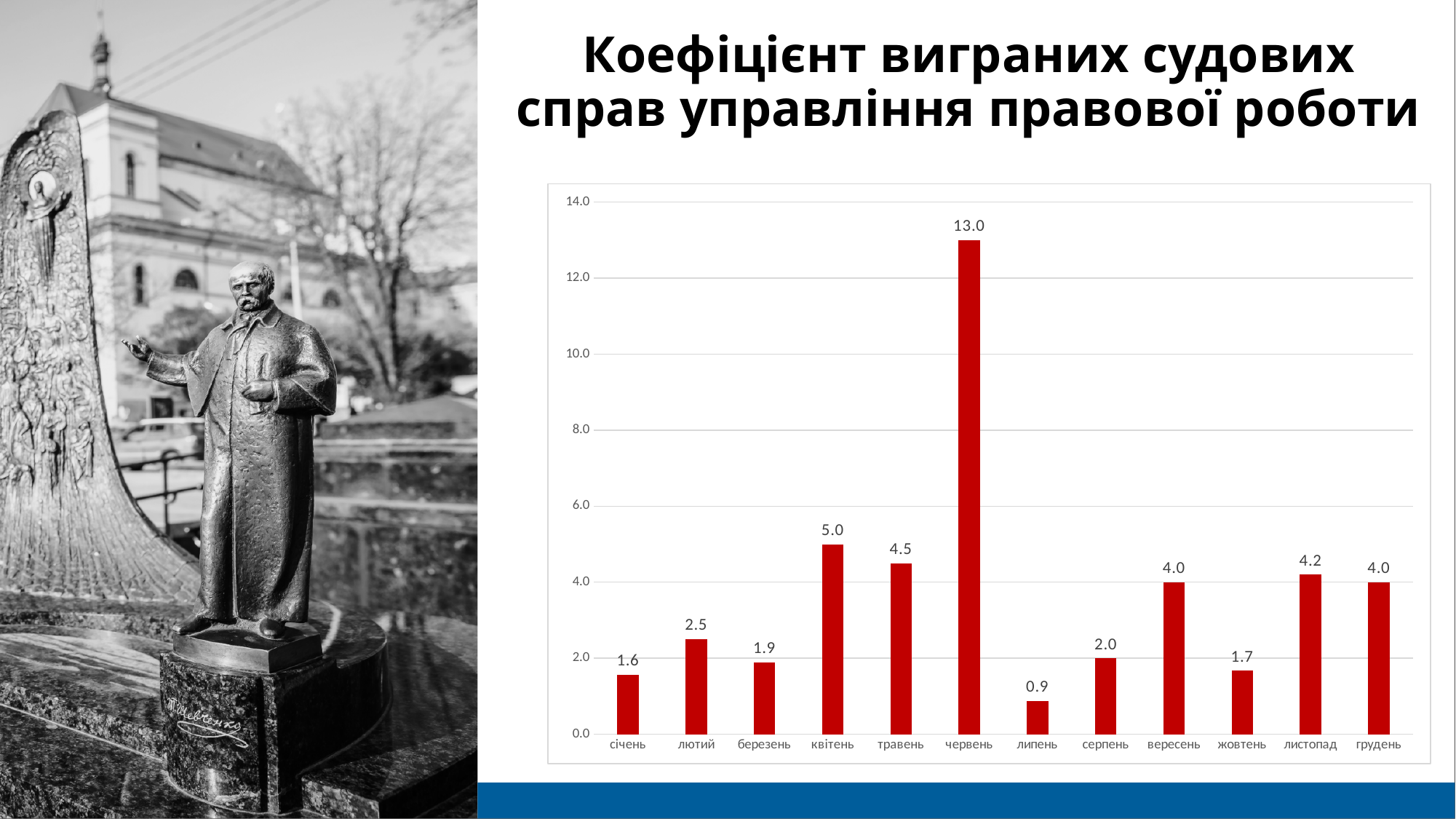
Is the value for червень greater or less than 12.0? greater What is the difference between the values for лютий and січень? 0.9 Which month has the lowest value? липень What is the value for квітень? 5.0 What colour are the bars in the chart? red What is the value for червень? 13.0 What is the value for листопад? 4.2 Which is larger, the value for травень or the value for вересень? травень What kind of chart is shown on the slide? bar chart Which month has the highest value? червень How many months are shown on the x axis? 12 What is the difference between the values for червень and квітень? 8.0